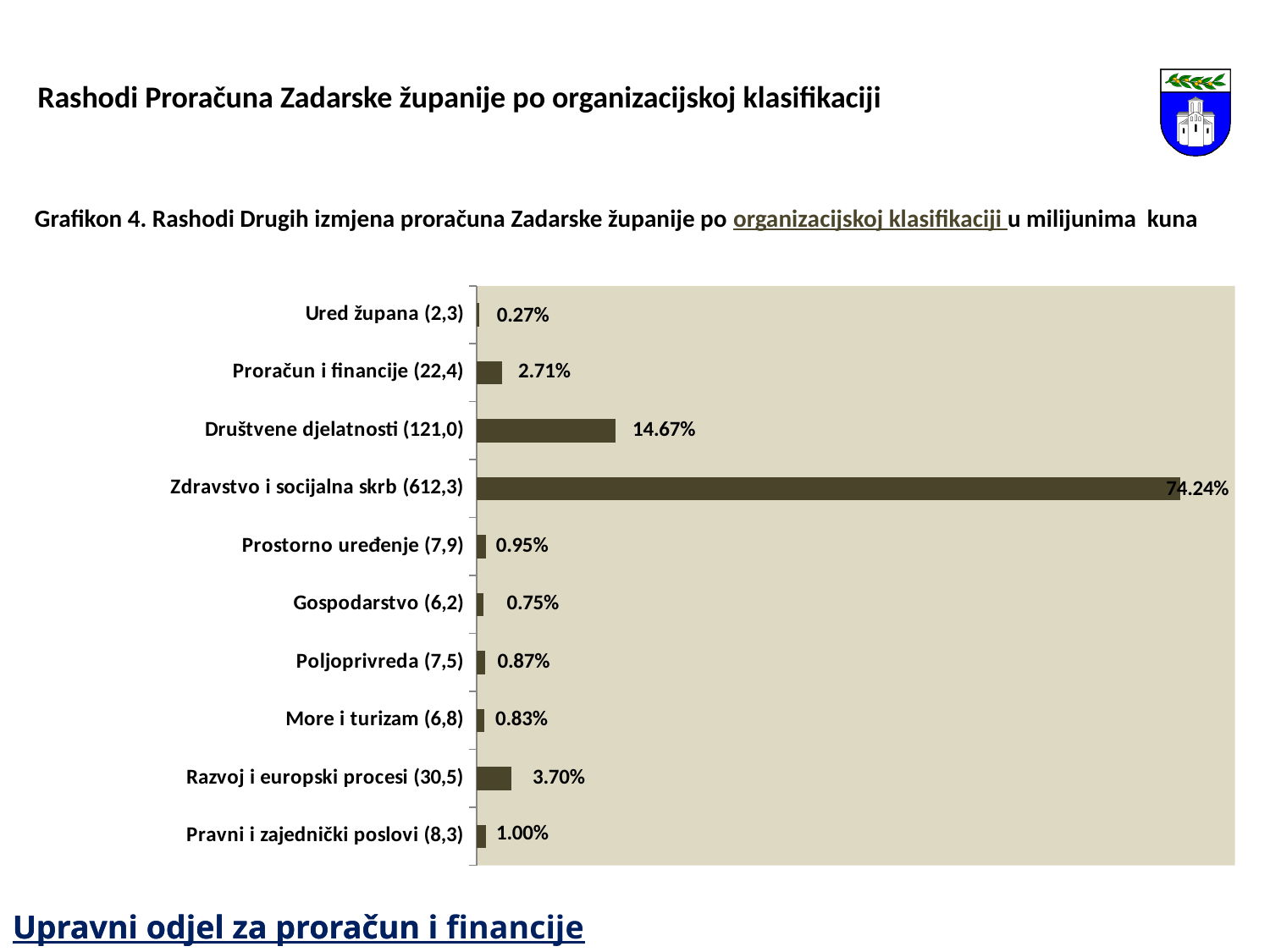
What is the title of the chart? Grafikon 4. Rashodi Drugih izmjena proračuna Zadarske županije po organizacijskoj klasifikaciji u milijunima kuna Which is larger, the value for Proračun i financije (22,4) or the value for Razvoj i europski procesi (30,5)? Razvoj i europski procesi (30,5) How many categories are shown in the chart? 10 What kind of chart is shown on the slide? Bar chart Which category has the lowest value? Ured župana (2,3) What is the difference between the values for Prostorno uređenje (7,9) and Gospodarstvo (6,2)? 0.20% What is the value for Društvene djelatnosti (121,0)? 14.67% Which category has the highest value? Zdravstvo i socijalna skrb (612,3) What is the value for Ured župana (2,3)? 0.27% What is the value for Razvoj i europski procesi (30,5)? 3.70% What is the difference between the values for Zdravstvo i socijalna skrb (612,3) and Društvene djelatnosti (121,0)? 59.57% What is the value for Zdravstvo i socijalna skrb (612,3)? 74.24%